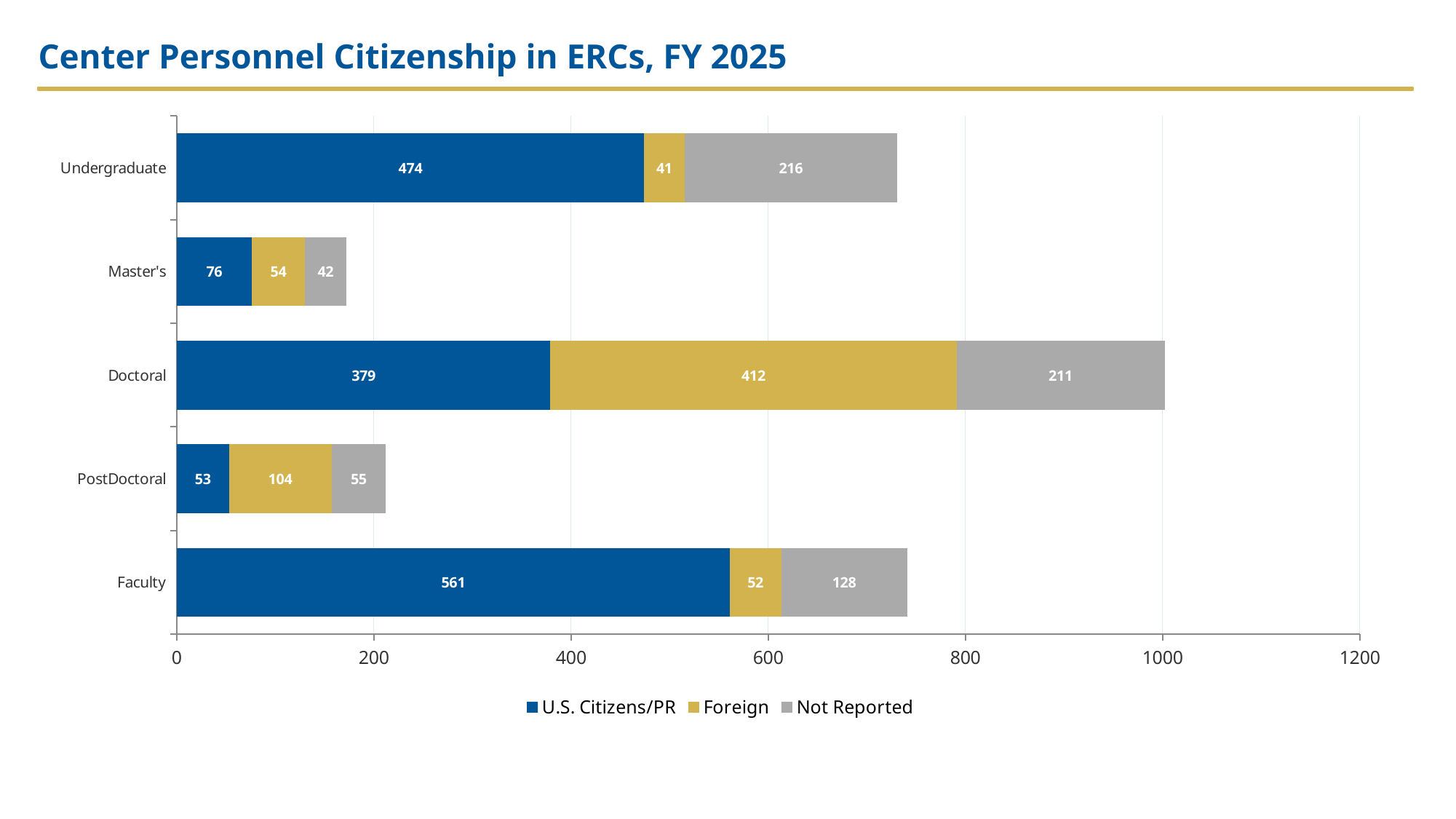
What is the difference between the Foreign values for Doctoral and PostDoctoral? 308 What is the Foreign value for Doctoral? 412 What is the Not Reported value for Faculty? 128 How many categories are shown on the chart? 5 What is the number of U.S. Citizens/PR for Undergraduate? 474 How many series does the legend list? 3 What is the total of the stacked bar for Master's? 172 Which is larger, the Not Reported value for Undergraduate or for Doctoral? Undergraduate What is the total of the stacked bar for Doctoral? 1002 Which category has the highest U.S. Citizens/PR value? Faculty What kind of chart is shown on the slide? Stacked bar chart Which category has the lowest Foreign value? Undergraduate